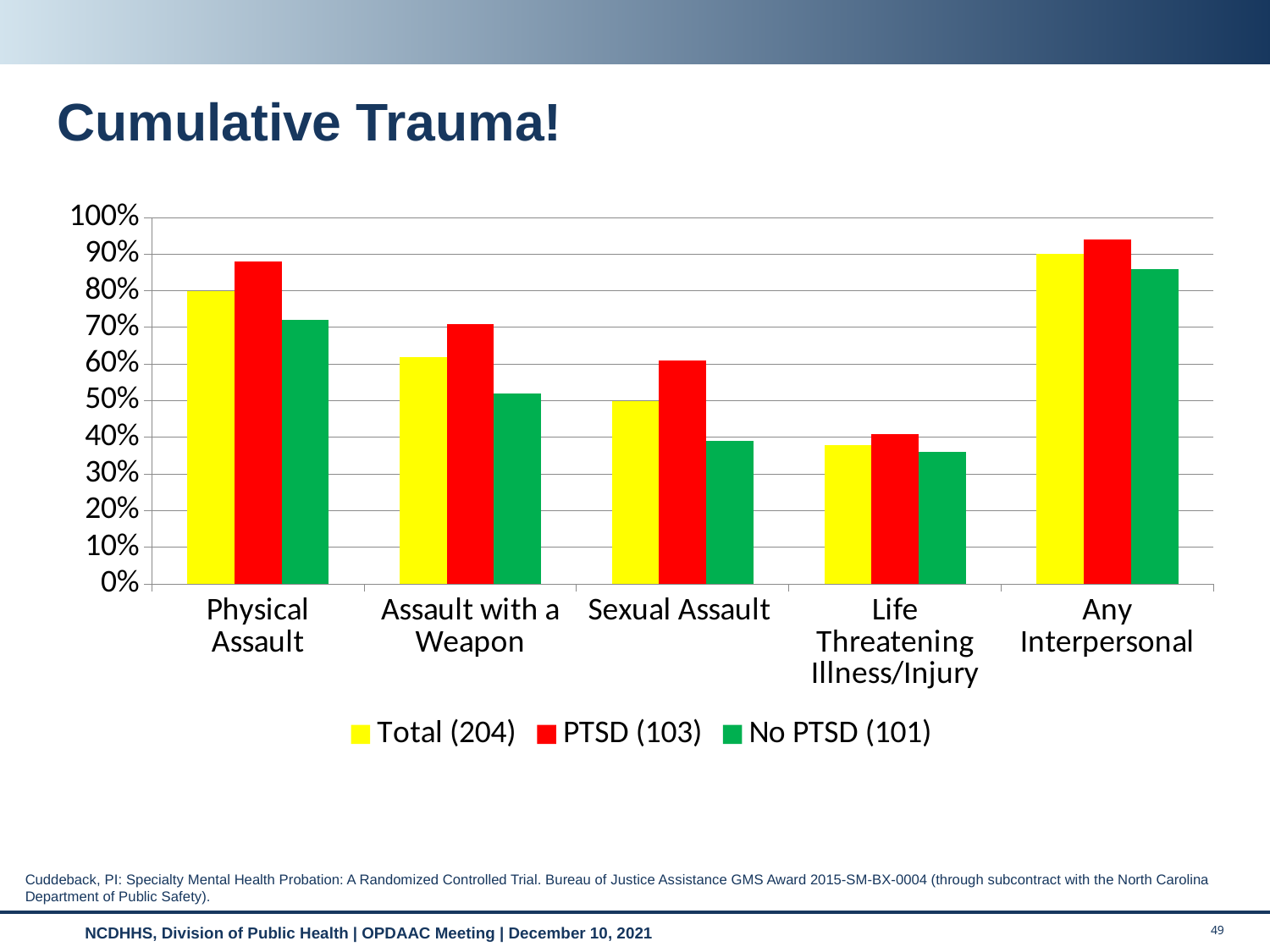
For Assault with a Weapon, which series has the larger value: Total (204) or No PTSD (101)? Total (204) What is the title of the slide containing the chart? Cumulative Trauma! Is the value for PTSD (103) in Physical Assault greater or less than 80%? greater How many series does the legend list? 3 Which category has the lowest value for the No PTSD (101) series? Life Threatening Illness/Injury Which category has the lowest value for the Total (204) series? Life Threatening Illness/Injury For Sexual Assault, which series has the larger value: PTSD (103) or No PTSD (101)? PTSD (103) Is the value for No PTSD (101) in Sexual Assault greater or less than 50%? less How many trauma categories are shown on the x axis? 5 Which category has the highest value for the PTSD (103) series? Any Interpersonal What kind of chart is shown on the slide? bar chart Is the value for PTSD (103) in Any Interpersonal greater or less than 90%? greater